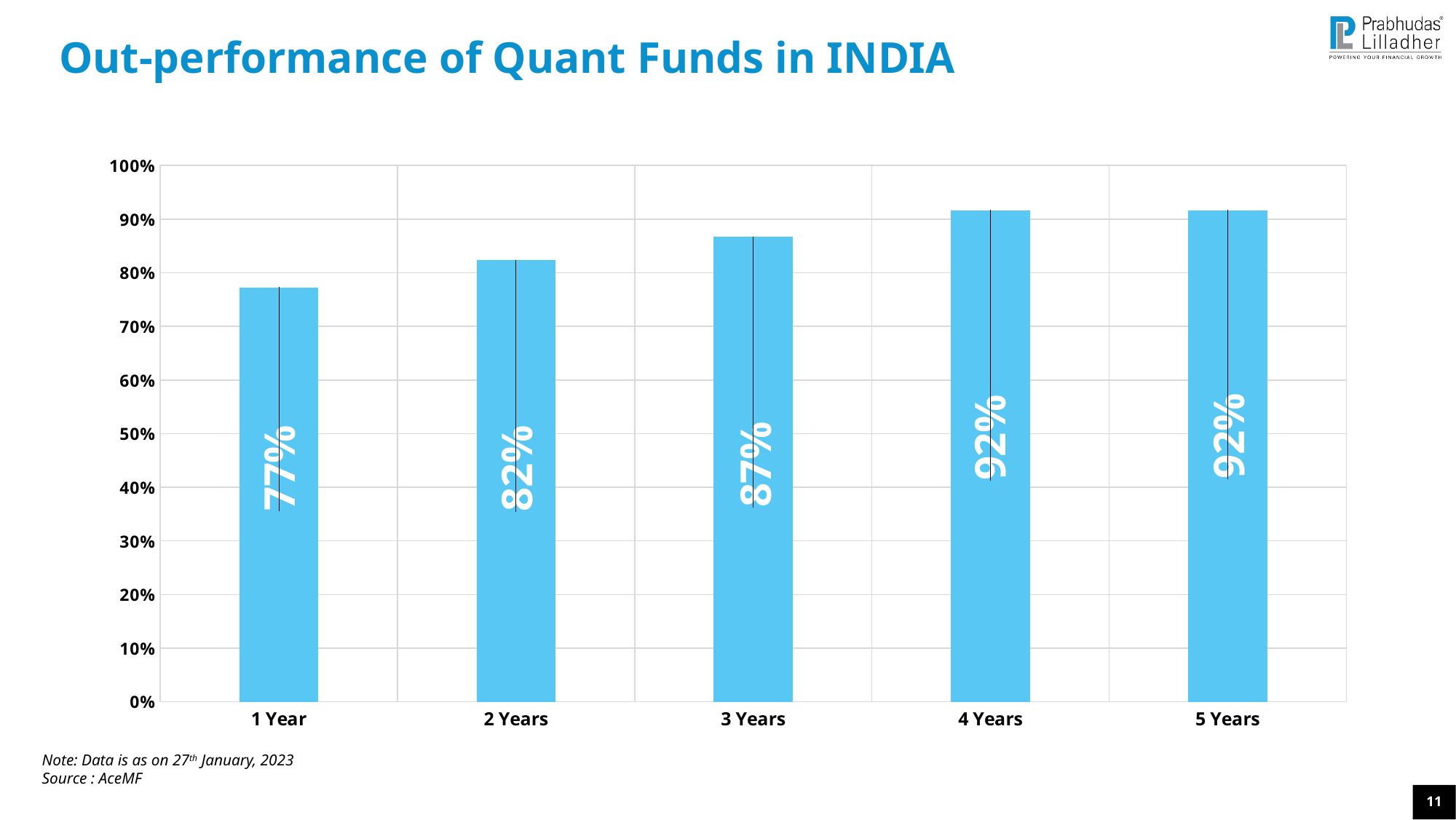
How many categories are shown on the x axis? 5 Do the values rise or fall from 1 Year to 5 Years? rise What is the value for 3 Years? 87% What is the difference between the values for 4 Years and 3 Years? 5% What is the value for 1 Year? 77% Which category has the lowest value? 1 Year What is the difference between the values for 2 Years and 1 Year? 5% Is the value for 1 Year greater or less than 80%? less Which is larger, the value for 3 Years or the value for 2 Years? 3 Years What is the value for 5 Years? 92% What kind of chart is shown on the slide? bar chart What is the title of the slide? Out-performance of Quant Funds in INDIA